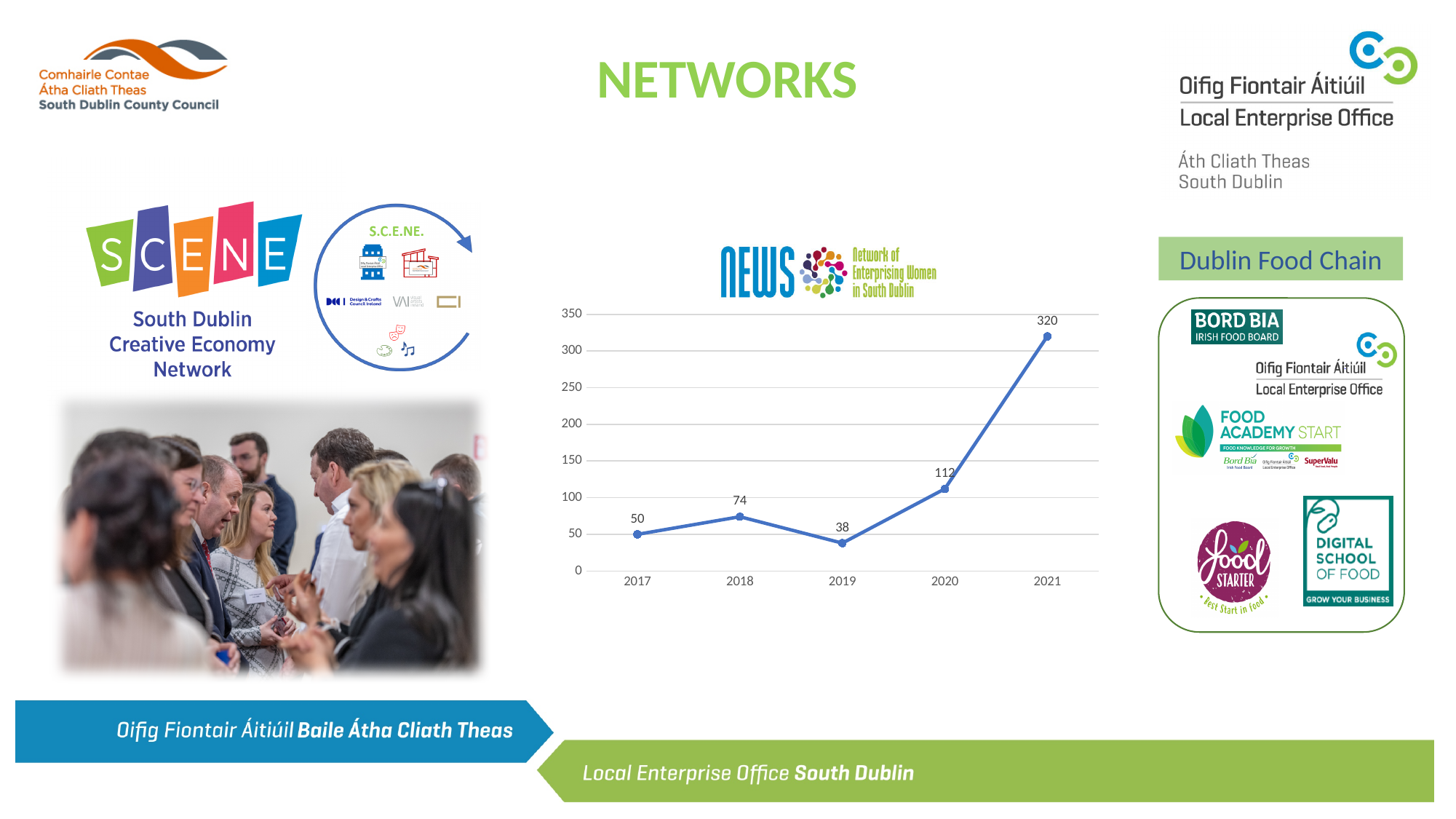
What is the difference between the values for 2021 and 2020 on the line chart? 208 What is the value for 2017 on the line chart? 50 Which is larger on the line chart, the value for 2018 or the value for 2019? 2018 What is the value for 2021 on the line chart? 320 How many years are plotted on the line chart? 5 What is the value for 2019 on the line chart? 38 Which year has the highest value on the line chart? 2021 What kind of chart is shown on the slide? line chart Which year has the lowest value on the line chart? 2019 What is the difference between the values for 2018 and 2017 on the line chart? 24 Does the value on the line chart rise or fall from 2019 to 2021? rise Is the value for 2020 on the line chart greater or less than 100? greater